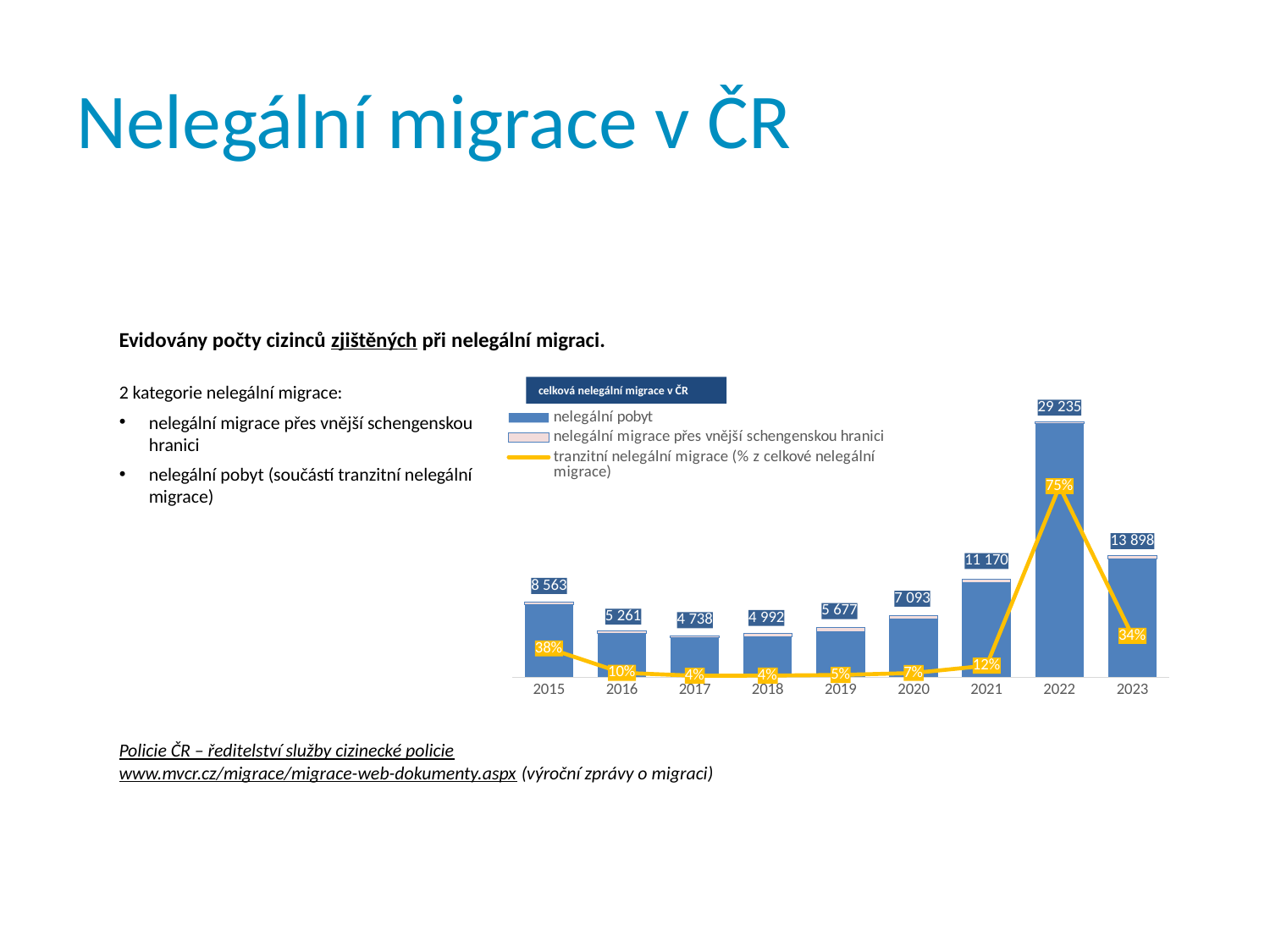
By how many percentage points does the transit migration share in 2022 exceed that in 2023? 41% What is the total illegal migration value shown for 2015? 8 563 How many series does the chart legend list? 3 What is the total illegal migration value shown for 2022? 29 235 What percentage does the transit illegal migration line show for 2023? 34% Do the total illegal migration values rise or fall from 2017 to 2022? rise Which year has the lowest total illegal migration? 2017 What percentage does the transit illegal migration line show for 2016? 10% What is the difference between the total values for 2022 and 2023? 15 337 Which year has a larger total illegal migration, 2019 or 2020? 2020 How many years are shown on the x axis of the chart? 9 Which year has the highest total illegal migration? 2022